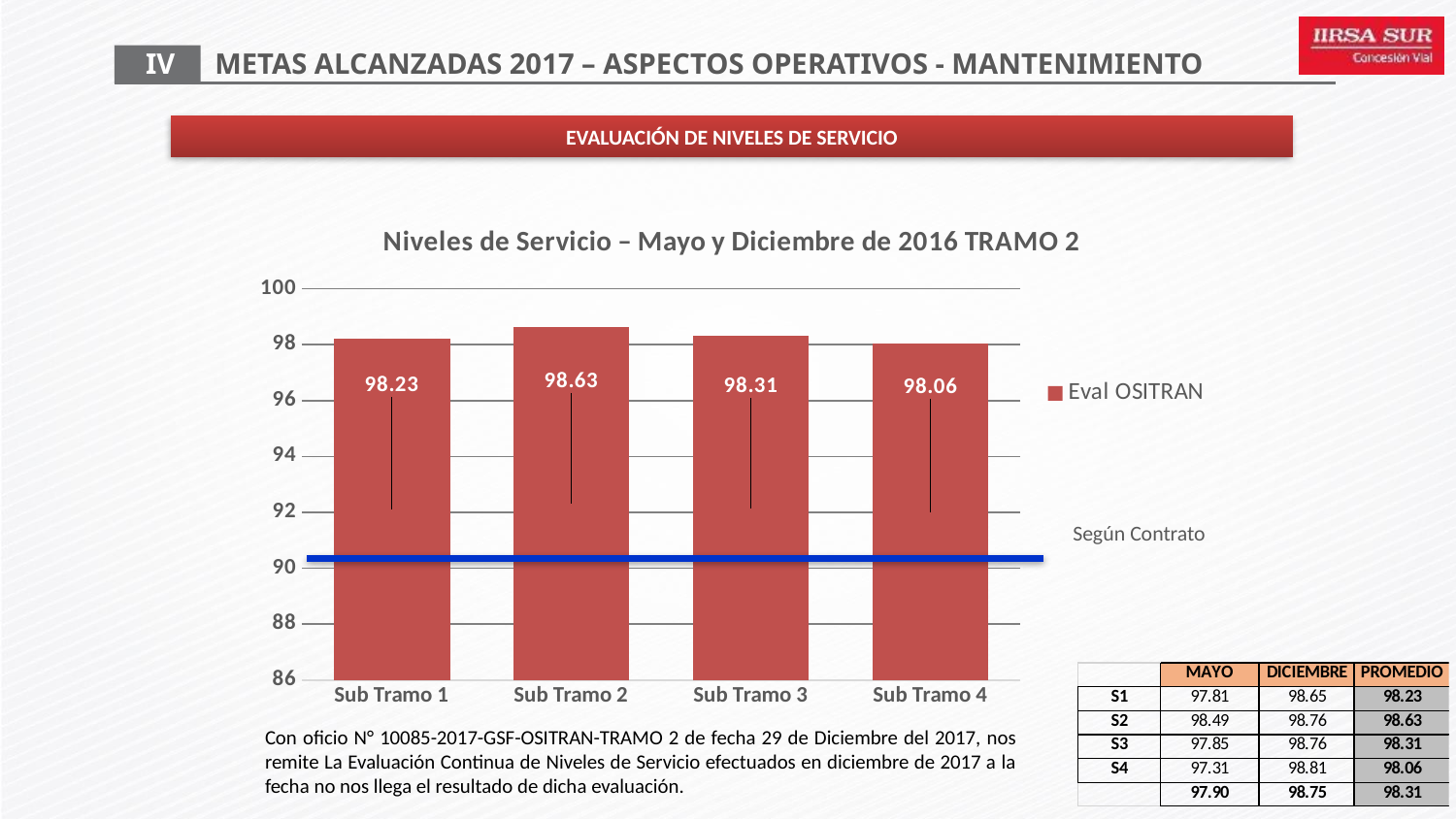
Is the Según Contrato line greater or less than 92? less What is the Eval OSITRAN value for Sub Tramo 2? 98.63 What is the Eval OSITRAN value for Sub Tramo 4? 98.06 How many sub tramos are shown on the x axis of the chart? 4 What is the Eval OSITRAN value for Sub Tramo 1? 98.23 What kind of chart is used to show the Eval OSITRAN values? Bar chart Which has a larger Eval OSITRAN value, Sub Tramo 1 or Sub Tramo 3? Sub Tramo 3 What is the difference between the Eval OSITRAN values for Sub Tramo 2 and Sub Tramo 4? 0.57 What is the Eval OSITRAN value for Sub Tramo 3? 98.31 What is the title of the chart? Niveles de Servicio – Mayo y Diciembre de 2016 TRAMO 2 Which sub tramo has the highest Eval OSITRAN value? Sub Tramo 2 Which sub tramo has the lowest Eval OSITRAN value? Sub Tramo 4